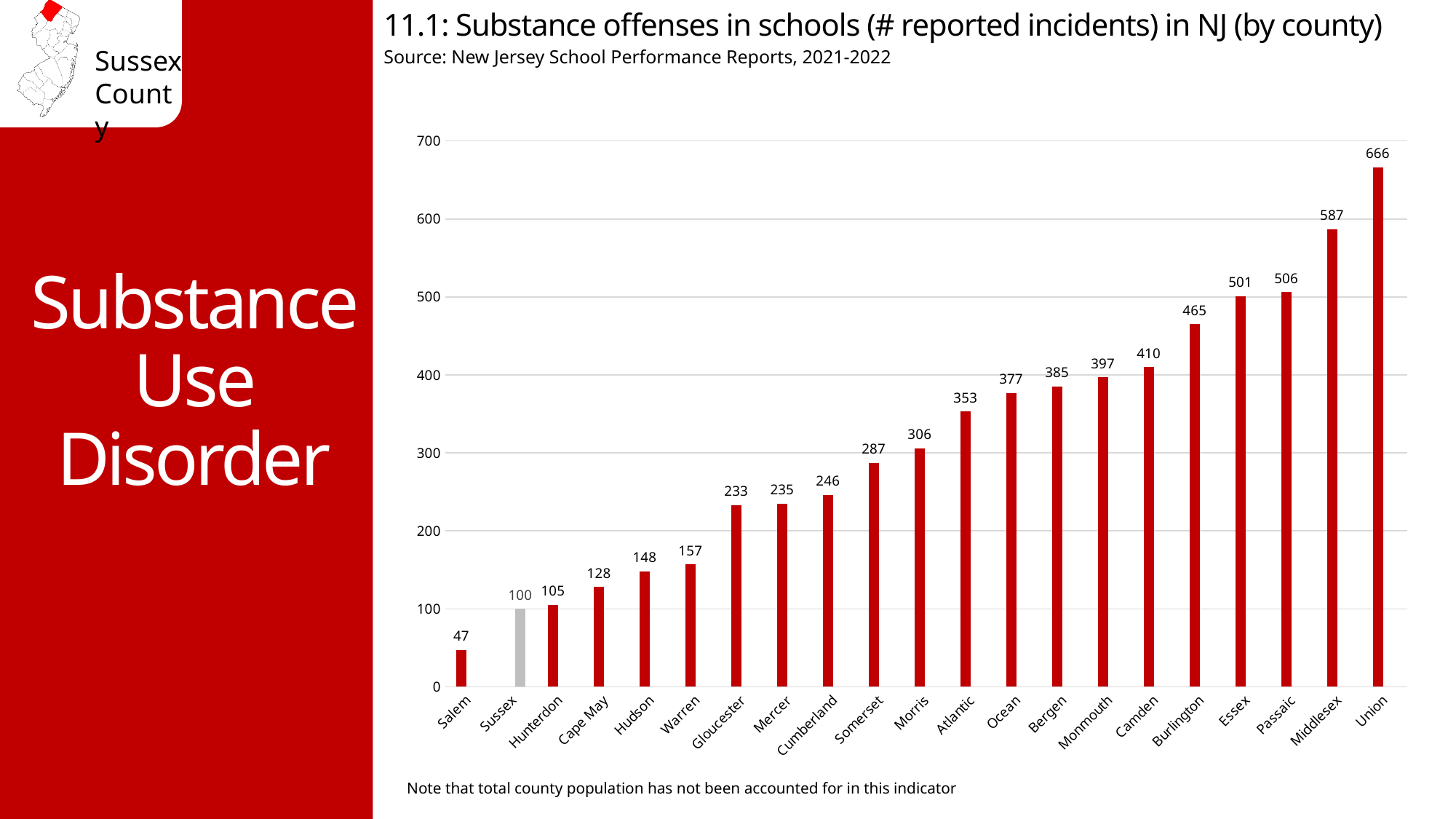
How many counties are shown on the chart? 21 Is the value for Somerset greater or less than 300? less Do the values rise or fall moving from left to right along the x axis? Rise Which county has the highest number of reported incidents? Union Which county has the lowest number of reported incidents? Salem What is the difference between the values for Union and Middlesex? 79 What is the value shown for Middlesex County? 587 What is the difference between the values for Hunterdon and Sussex? 5 Which county has a larger value, Camden or Bergen? Camden Which county's bar is coloured grey instead of red? Sussex What is the number of reported substance offense incidents in schools for Sussex County? 100 What kind of chart is shown on the slide? Bar chart